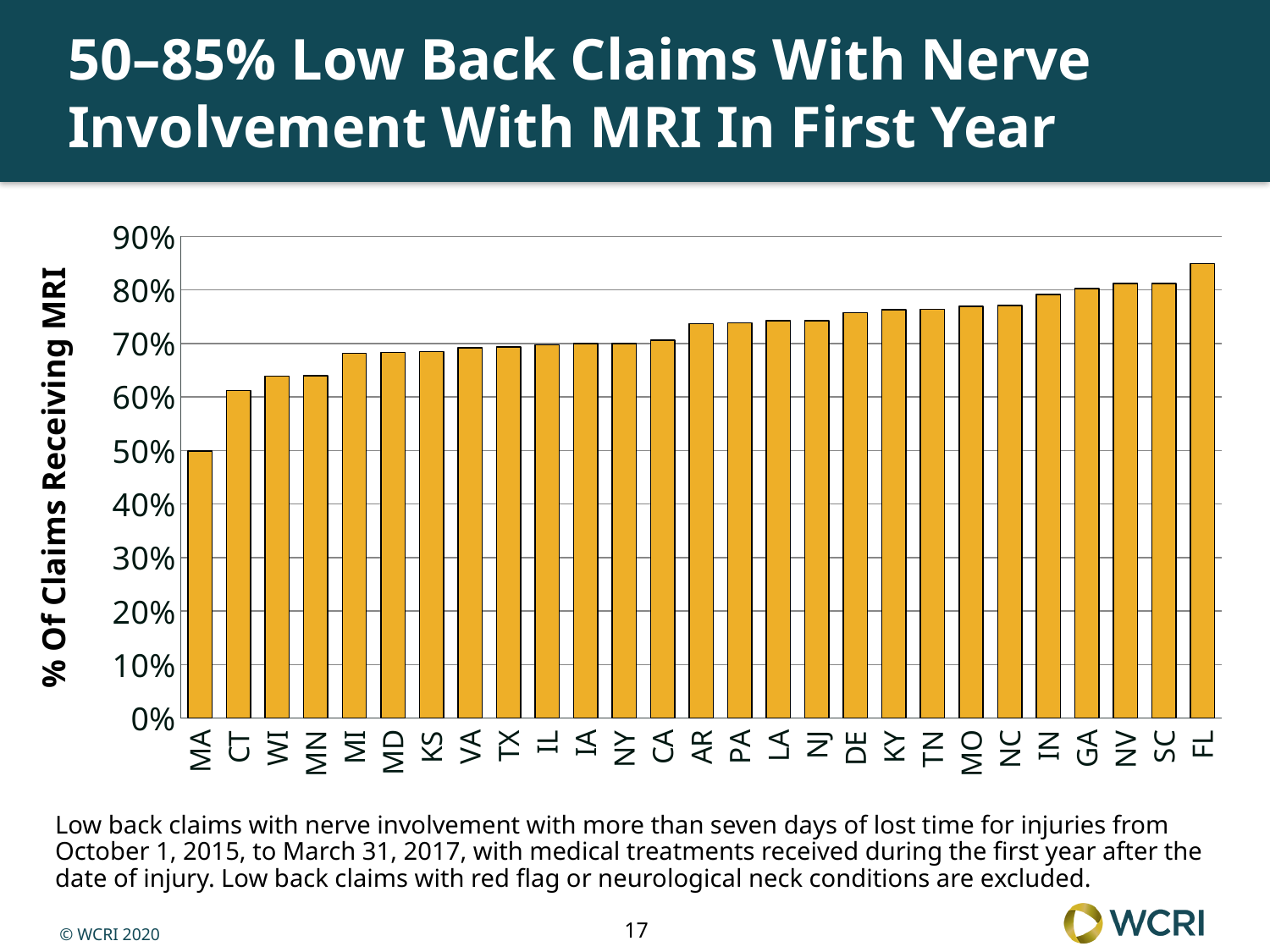
How many states are shown on the x axis of the chart? 27 What kind of chart is shown on the slide? bar chart Is the value for CT greater or less than 70%? less Is the value for WI greater or less than 60%? greater Which state has the highest percentage of claims receiving MRI? FL Is the value for NC greater or less than 80%? less Which state has a higher percentage of claims receiving MRI, MI or DE? DE What is the title of the y axis? % Of Claims Receiving MRI Do the values generally rise or fall moving from left to right along the x axis? rise Which state has the lowest percentage of claims receiving MRI? MA